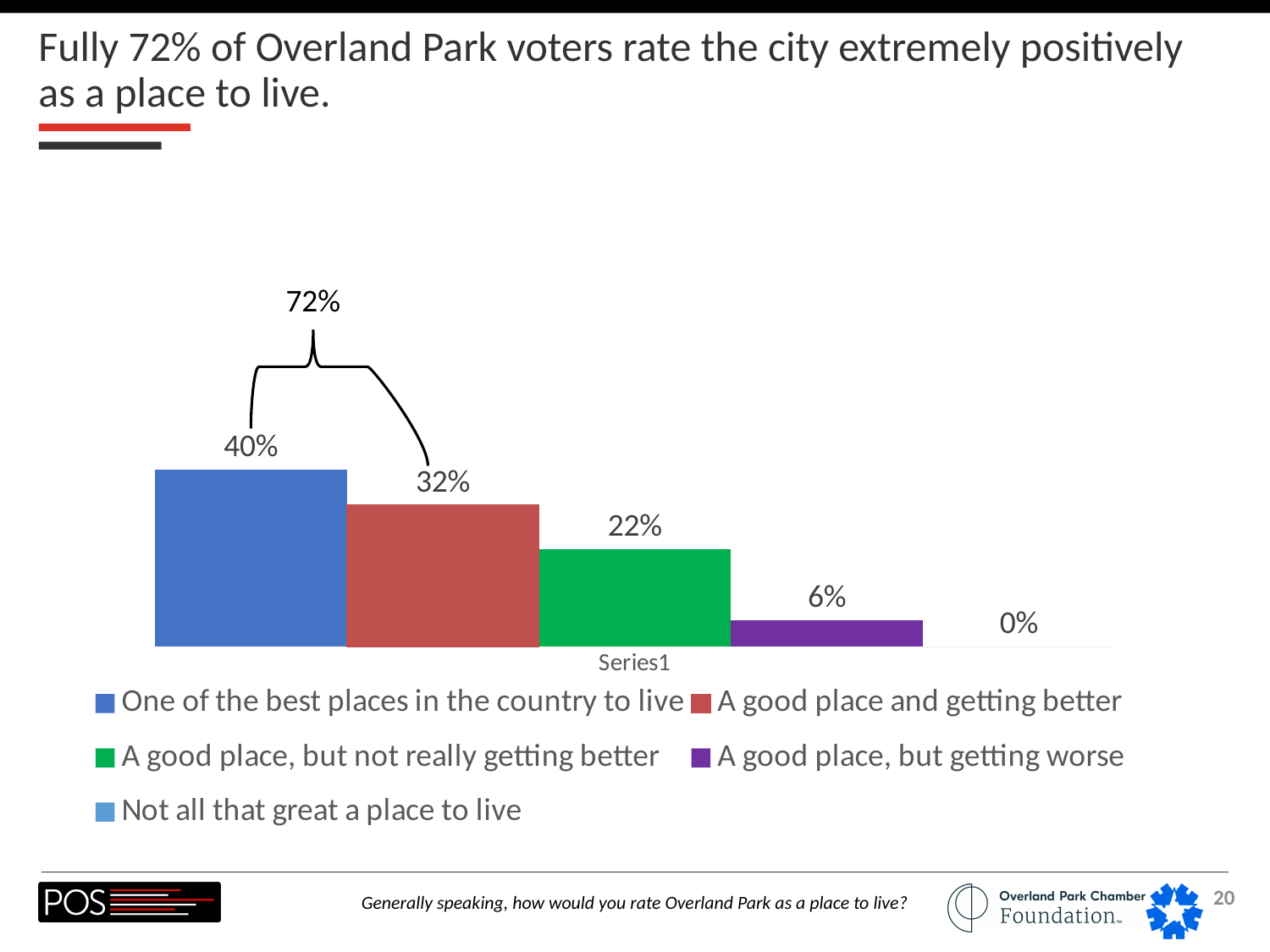
Which response category has the lowest percentage? Not all that great a place to live Which response category has the highest percentage? One of the best places in the country to live What is the difference between the percentage for 'One of the best places in the country to live' and 'A good place and getting better'? 8% What percentage of voters said Overland Park is one of the best places in the country to live? 40% What percentage of voters said Overland Park is not all that great a place to live? 0% Which is larger: the percentage for 'A good place, but not really getting better' or 'A good place, but getting worse'? A good place, but not really getting better What percentage of voters said Overland Park is a good place, but getting worse? 6% What percentage of voters said Overland Park is a good place and getting better? 32% What percentage of voters said Overland Park is a good place, but not really getting better? 22% How many response categories does the legend list? 5 What kind of chart is shown on the slide? Bar chart What combined percentage is shown by the bracket above the first two bars? 72%